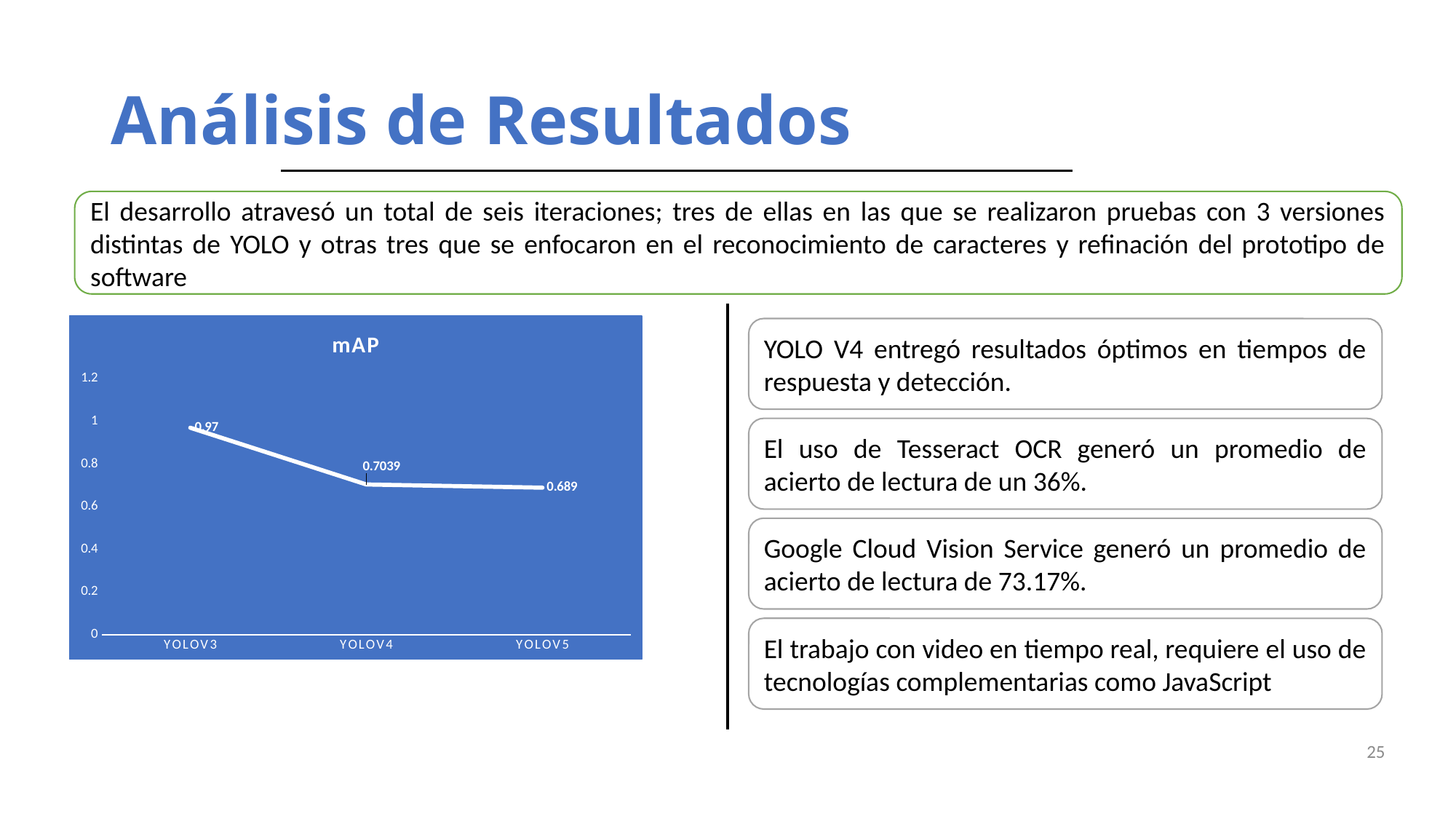
What is the mAP value for YOLOV4? 0.7039 Which YOLO version has the highest mAP? YOLOV3 Which has a higher mAP, YOLOV4 or YOLOV5? YOLOV4 How many YOLO versions are plotted in the mAP chart? 3 What is the mAP value for YOLOV3? 0.97 What kind of chart is used to show mAP? line chart Which YOLO version has the lowest mAP? YOLOV5 Do the mAP values rise or fall from YOLOV3 to YOLOV5? fall What is the difference in mAP between YOLOV3 and YOLOV4? 0.2661 What is the mAP value for YOLOV5? 0.689 What is the difference in mAP between YOLOV3 and YOLOV5? 0.281 Is the mAP value for YOLOV3 greater or less than 0.8? greater